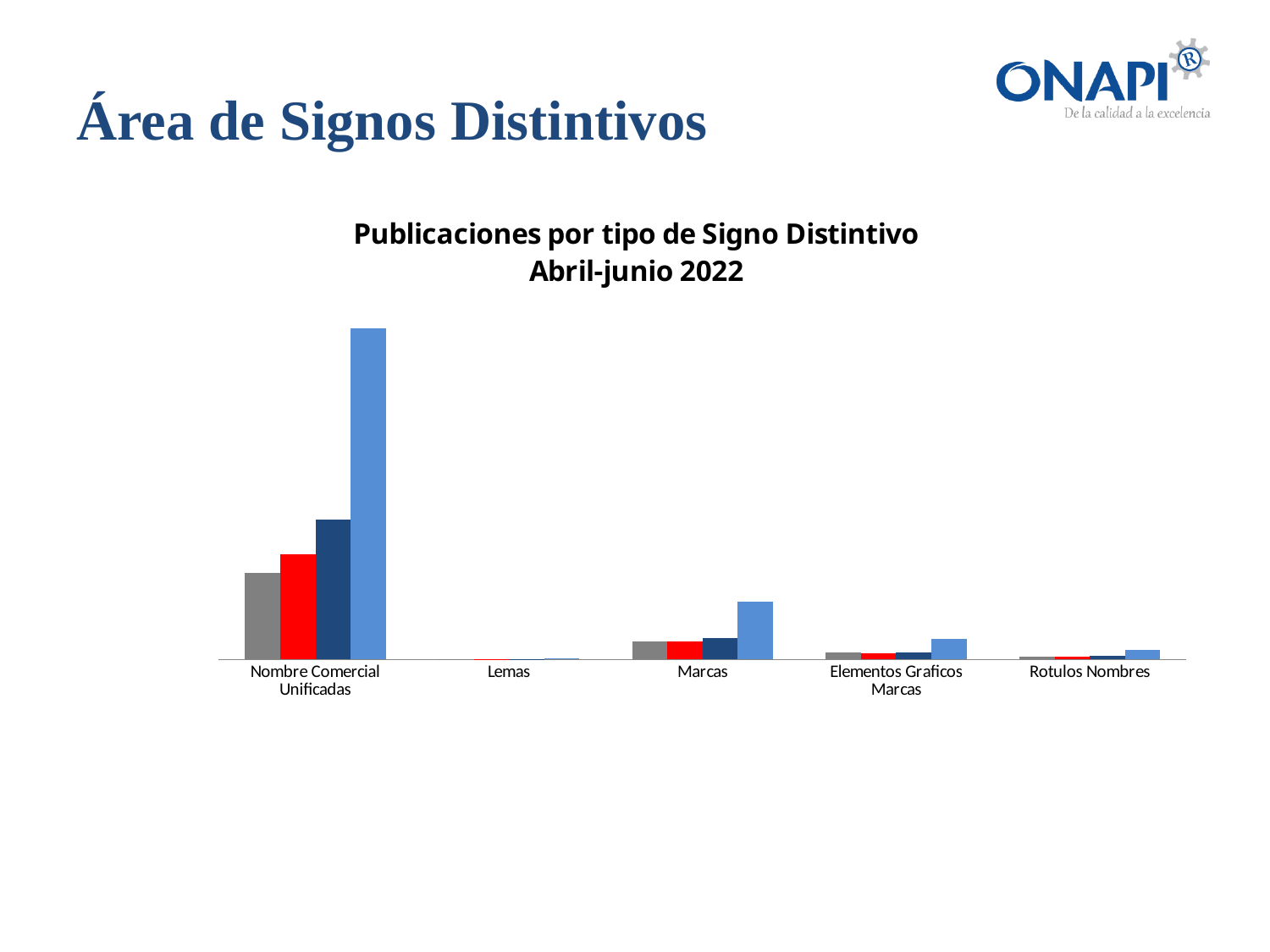
What is the title of the chart? Publicaciones por tipo de Signo Distintivo Abril-junio 2022 Which category has the second tallest bars in the chart? Marcas Which category has the tallest bars in the chart? Nombre Comercial Unificadas How many bars are plotted for each category in the chart? 4 What kind of chart is shown on the slide? Bar chart Which category has larger bars, Marcas or Elementos Graficos Marcas? Marcas Which category has larger bars, Rotulos Nombres or Lemas? Rotulos Nombres Within the Nombre Comercial Unificadas category, which coloured bar is the tallest? The light blue bar How many categories are shown on the x axis of the chart? 5 Which category has the smallest bars in the chart? Lemas Which category has larger bars, Nombre Comercial Unificadas or Marcas? Nombre Comercial Unificadas